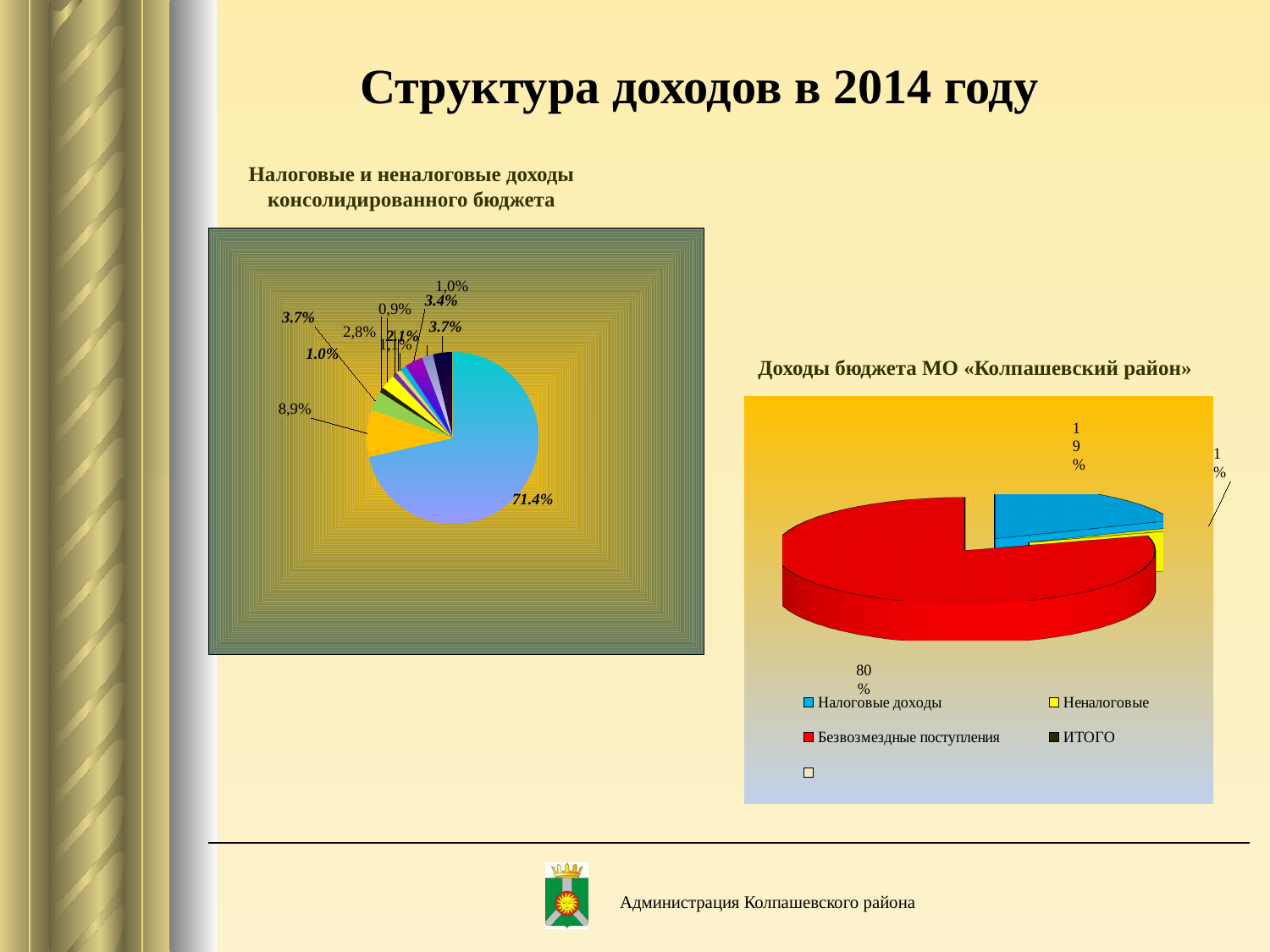
In the chart «Доходы бюджета МО «Колпашевский район»», what share is shown for Неналоговые? 1% In the chart «Доходы бюджета МО «Колпашевский район»», by how many percentage points does Безвозмездные поступления exceed Налоговые доходы? 61 percentage points In the chart «Доходы бюджета МО «Колпашевский район»», what colour is the slice for Безвозмездные поступления? red In the chart «Доходы бюджета МО «Колпашевский район»», which is larger: Налоговые доходы or Безвозмездные поступления? Безвозмездные поступления In the chart «Доходы бюджета МО «Колпашевский район»», which category has the smallest slice? Неналоговые What kind of chart is the chart titled «Доходы бюджета МО «Колпашевский район»»? pie chart In the chart «Доходы бюджета МО «Колпашевский район»», what share is shown for Налоговые доходы? 19% In the chart «Доходы бюджета МО «Колпашевский район»», which category has the largest slice? Безвозмездные поступления In the chart «Налоговые и неналоговые доходы консолидированного бюджета», what is the value of the second-largest slice? 8,9% What kind of chart is the chart titled «Налоговые и неналоговые доходы консолидированного бюджета»? pie chart In the chart «Налоговые и неналоговые доходы консолидированного бюджета», what is the value of the largest slice? 71.4% In the chart «Доходы бюджета МО «Колпашевский район»», what share is shown for Безвозмездные поступления? 80%